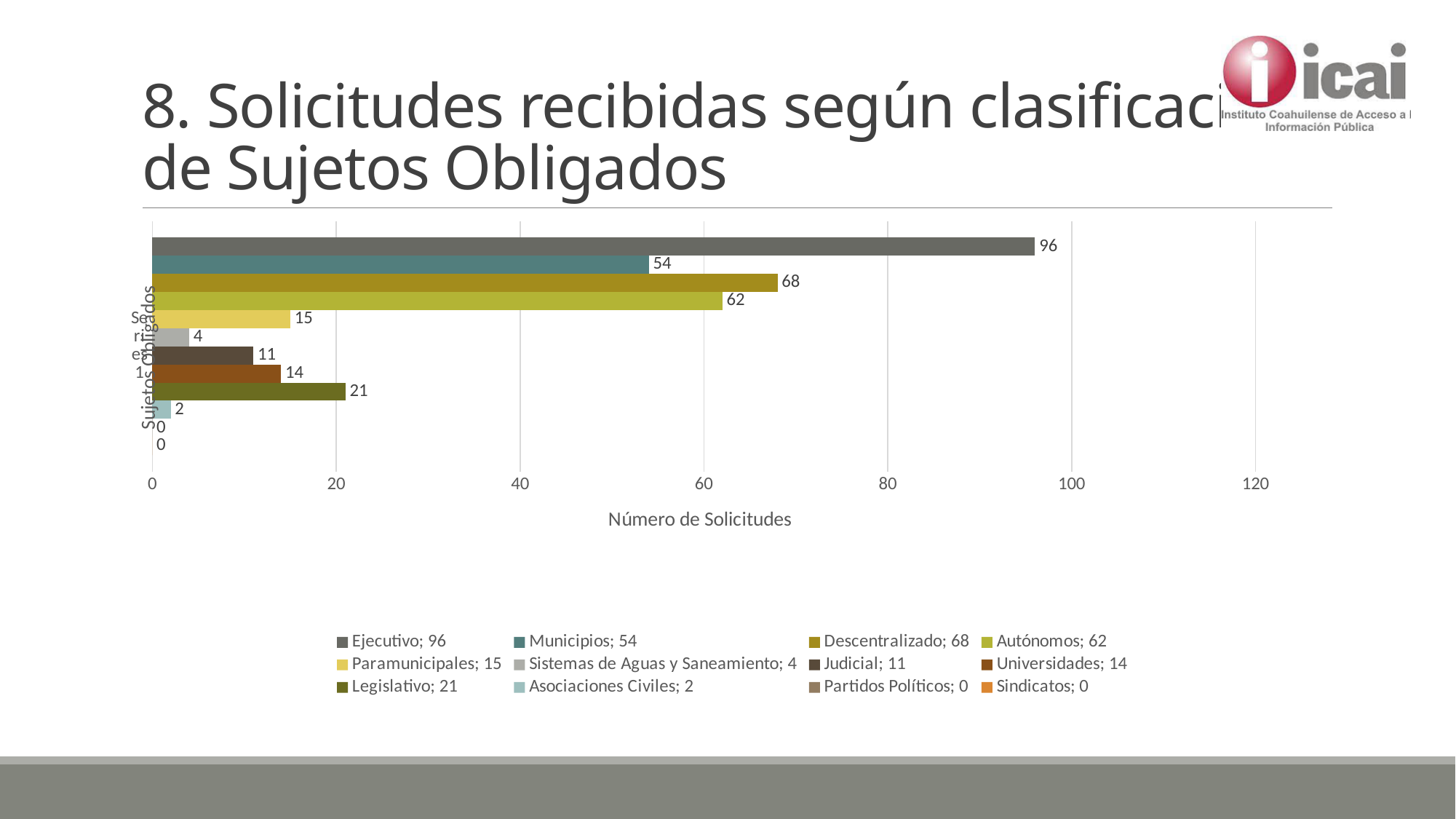
Which category has the highest number of solicitudes? Ejecutivo What is the number of solicitudes for Sistemas de Aguas y Saneamiento? 4 Which is larger, the value for Legislativo or the value for Paramunicipales? Legislativo What is the difference between the values for Descentralizado and Autónomos? 6 What kind of chart is shown on the slide? bar chart What is the difference between the values for Ejecutivo and Municipios? 42 How many series does the legend list? 12 What is the number of solicitudes for Municipios? 54 What is the label of the horizontal axis? Número de Solicitudes Which two categories have a value of 0? Partidos Políticos and Sindicatos Is the value for Municipios greater or less than 60? less What is the number of solicitudes for Ejecutivo? 96